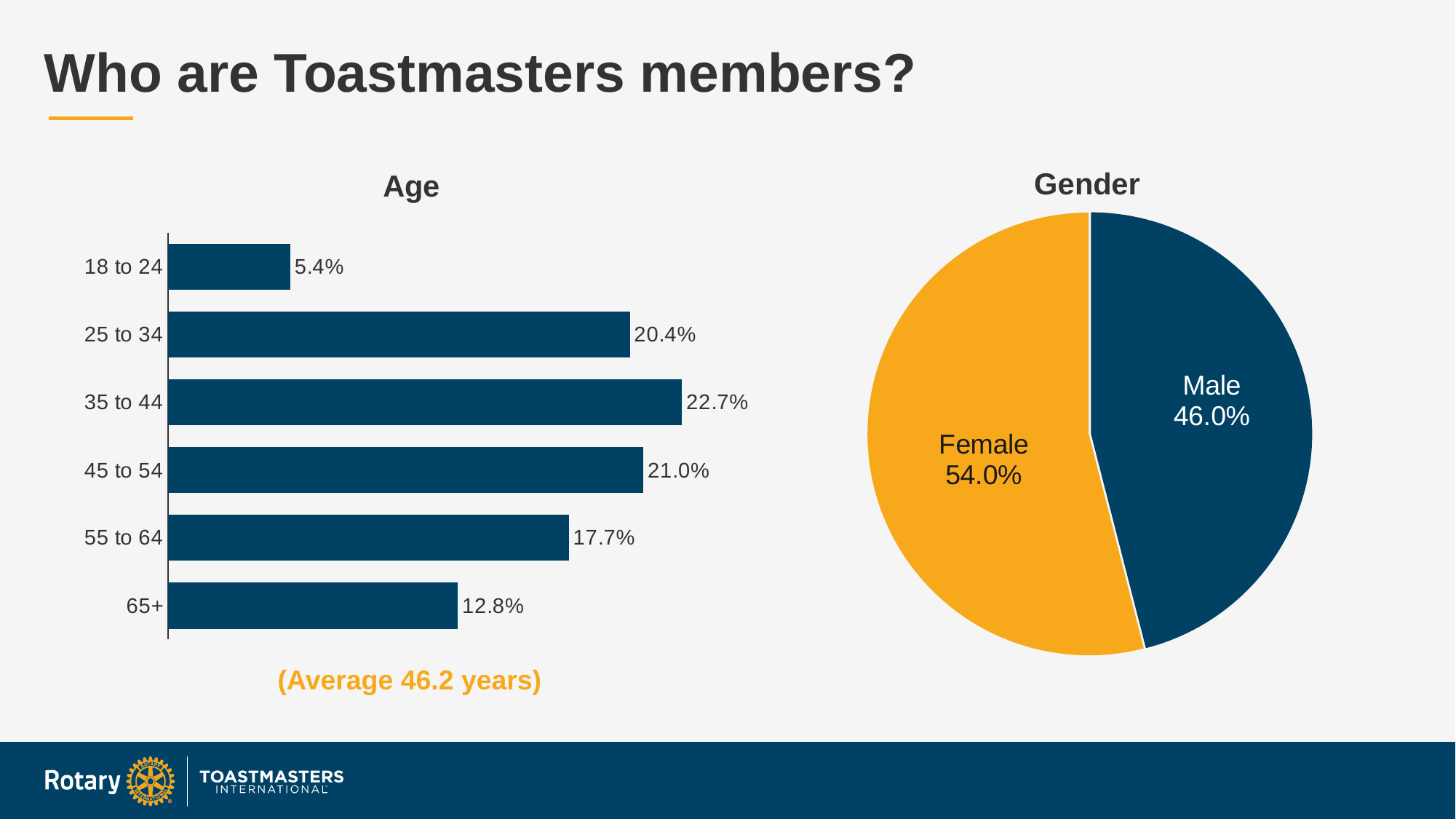
In the Age chart, what is the value for the 35 to 44 age group? 22.7% In the Age chart, which age group has the lowest value? 18 to 24 In the Age chart, what is the value for the 65+ age group? 12.8% In the Gender chart, what share of the pie is Female? 54.0% How many age groups are shown in the Age chart? 6 In the Age chart, which is larger: the value for 25 to 34 or the value for 45 to 54? 45 to 54 In the Age chart, which age group has the highest value? 35 to 44 In the Gender chart, what is the value for Male? 46.0% What kind of chart is the Age chart? Bar chart What kind of chart is the Gender chart? Pie chart What average age is stated below the Age chart? 46.2 years In the Age chart, what is the difference between the values for 45 to 54 and 55 to 64? 3.3%